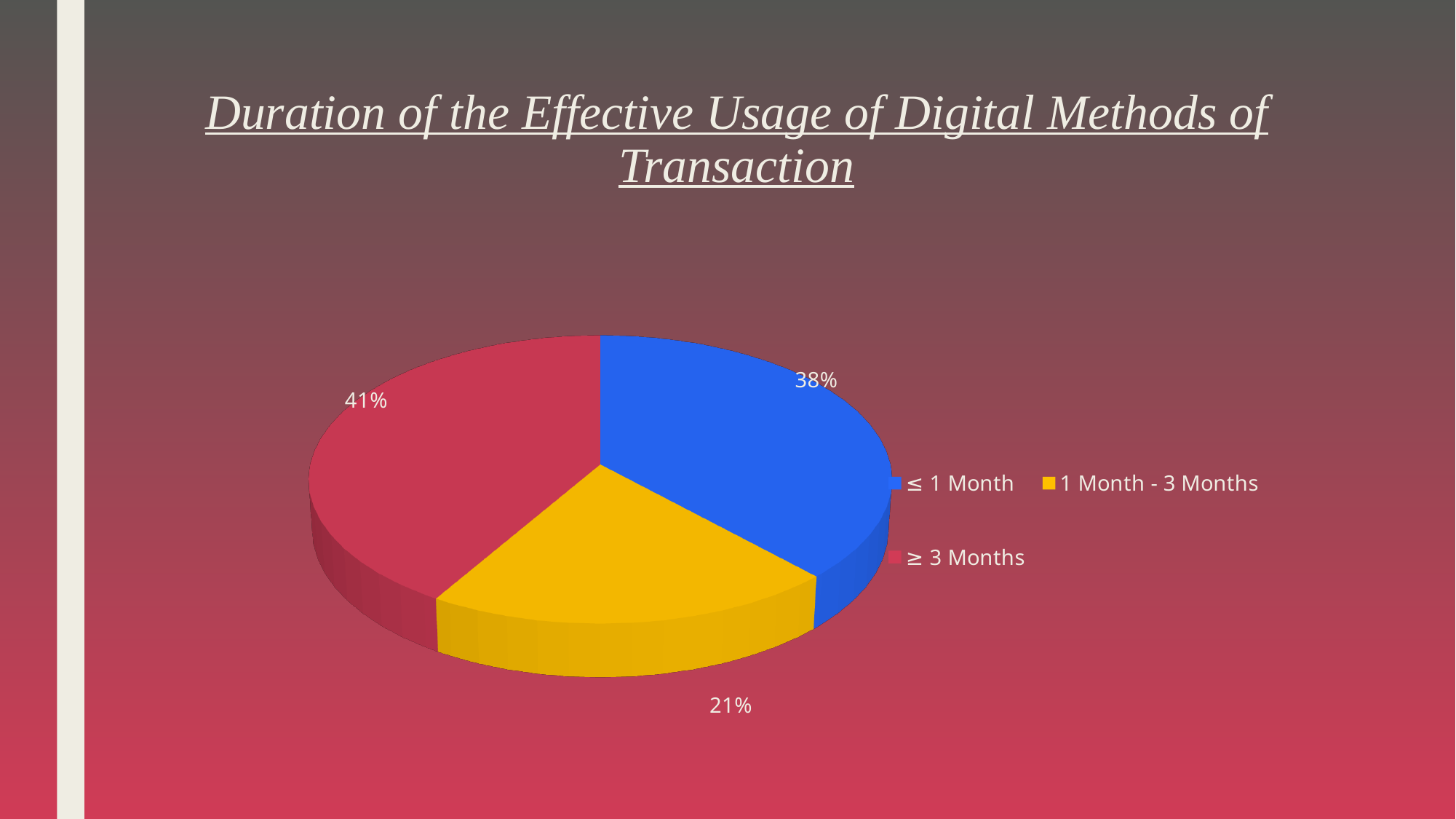
What is the title of the slide? Duration of the Effective Usage of Digital Methods of Transaction Which category has the largest slice of the pie? ≥ 3 Months What share of the pie does the "≥ 3 Months" slice represent? 41% What is the difference in percentage points between the "≥ 3 Months" slice and the "1 Month - 3 Months" slice? 20 What colour is the "1 Month - 3 Months" slice? Yellow How many categories does the pie chart have? 3 Which category has the smallest slice of the pie? 1 Month - 3 Months What share of the pie does the "≤ 1 Month" slice represent? 38% What share of the pie does the "1 Month - 3 Months" slice represent? 21% What kind of chart is shown on the slide? Pie chart What is the difference in percentage points between the "≥ 3 Months" slice and the "≤ 1 Month" slice? 3 Which is larger, the "≤ 1 Month" slice or the "1 Month - 3 Months" slice? ≤ 1 Month